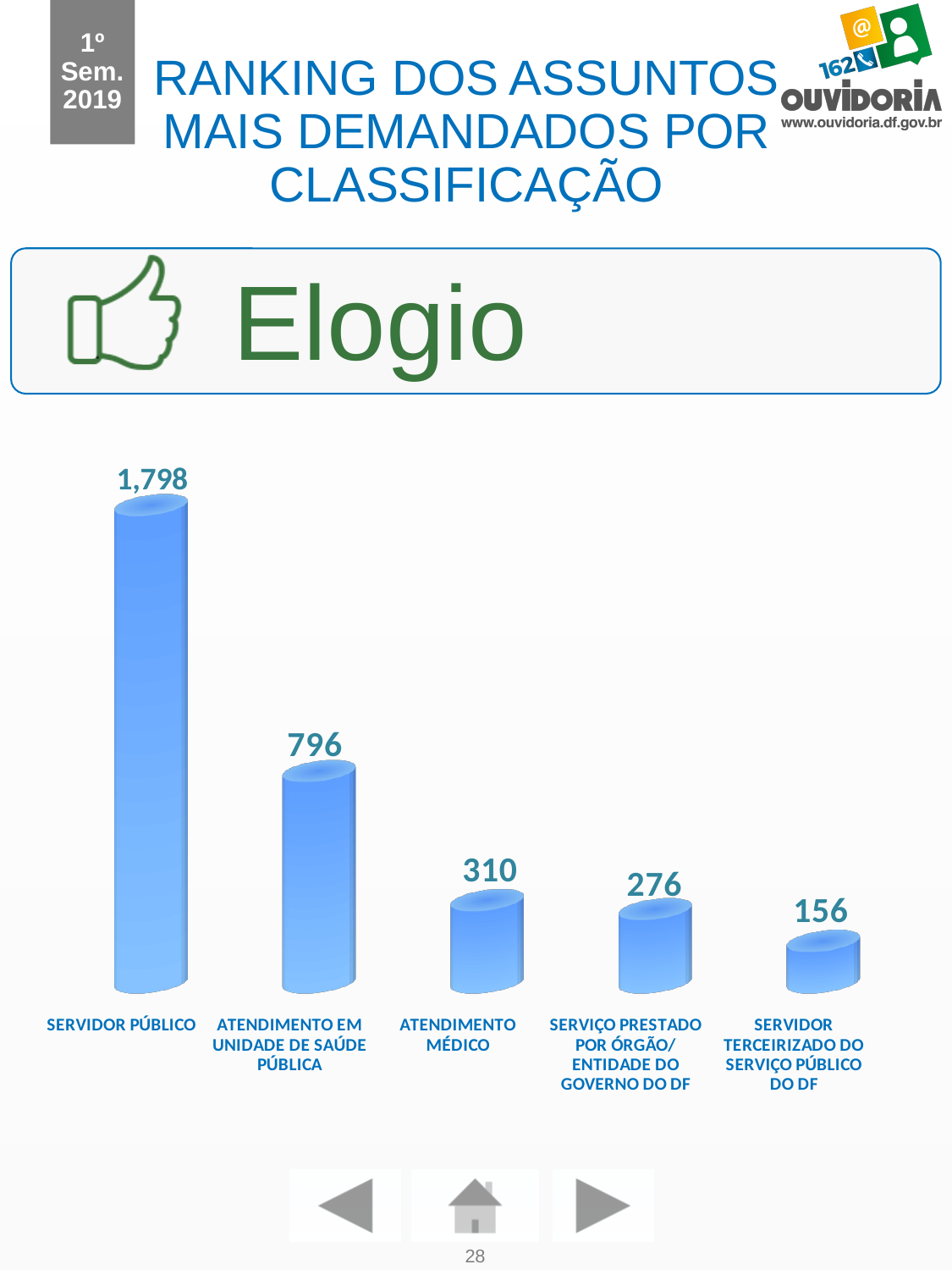
What is the value for SERVIDOR PÚBLICO? 1,798 Which is larger, the value for SERVIÇO PRESTADO POR ÓRGÃO/ENTIDADE DO GOVERNO DO DF or the value for SERVIDOR TERCEIRIZADO DO SERVIÇO PÚBLICO DO DF? SERVIÇO PRESTADO POR ÓRGÃO/ENTIDADE DO GOVERNO DO DF What is the difference between the values for SERVIDOR PÚBLICO and ATENDIMENTO EM UNIDADE DE SAÚDE PÚBLICA? 1,002 What is the value for ATENDIMENTO MÉDICO? 310 Which category has the highest value? SERVIDOR PÚBLICO What kind of chart is shown on the slide? bar chart What is the value for SERVIDOR TERCEIRIZADO DO SERVIÇO PÚBLICO DO DF? 156 How many categories are shown in the chart? 5 Which category has the lowest value? SERVIDOR TERCEIRIZADO DO SERVIÇO PÚBLICO DO DF What is the difference between the values for ATENDIMENTO MÉDICO and SERVIÇO PRESTADO POR ÓRGÃO/ENTIDADE DO GOVERNO DO DF? 34 What is the value for ATENDIMENTO EM UNIDADE DE SAÚDE PÚBLICA? 796 Do the values rise or fall from left to right across the categories? fall